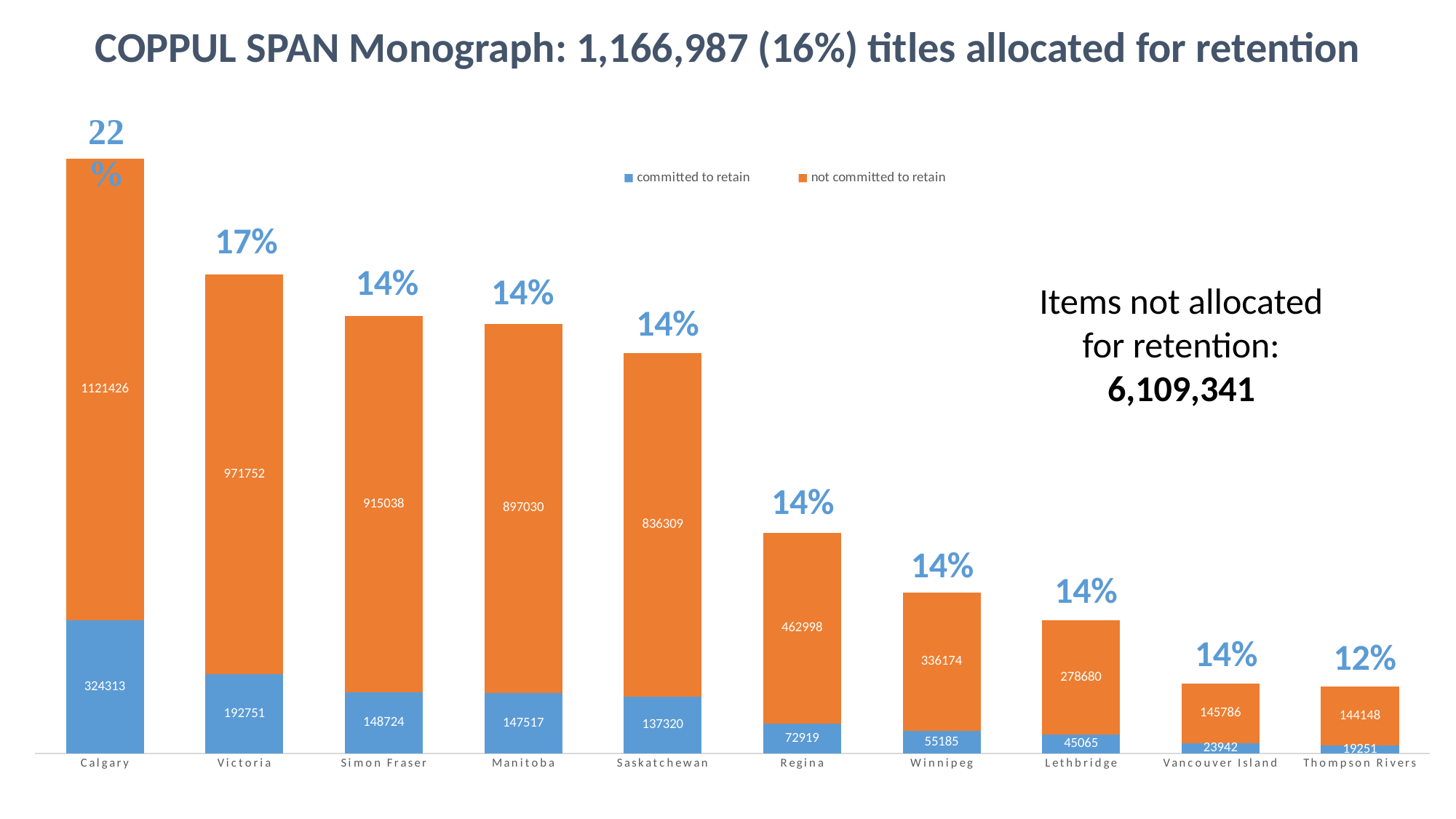
Which institution has the lowest 'committed to retain' value? Thompson Rivers What percentage label is shown above the Victoria bar? 17% How many institutions are shown on the x axis? 10 What is the 'committed to retain' value for Calgary? 324313 What is the 'not committed to retain' value for Saskatchewan? 836309 Which institution has the highest 'not committed to retain' value? Calgary How many series does the legend list? 2 What is the difference between the 'committed to retain' values for Victoria and Simon Fraser? 44027 What kind of chart is shown on the slide? stacked bar chart Which is larger, the 'not committed to retain' value for Regina or for Winnipeg? Regina What is the total of the stacked bar for Lethbridge? 323745 What is the 'committed to retain' value for Thompson Rivers? 19251